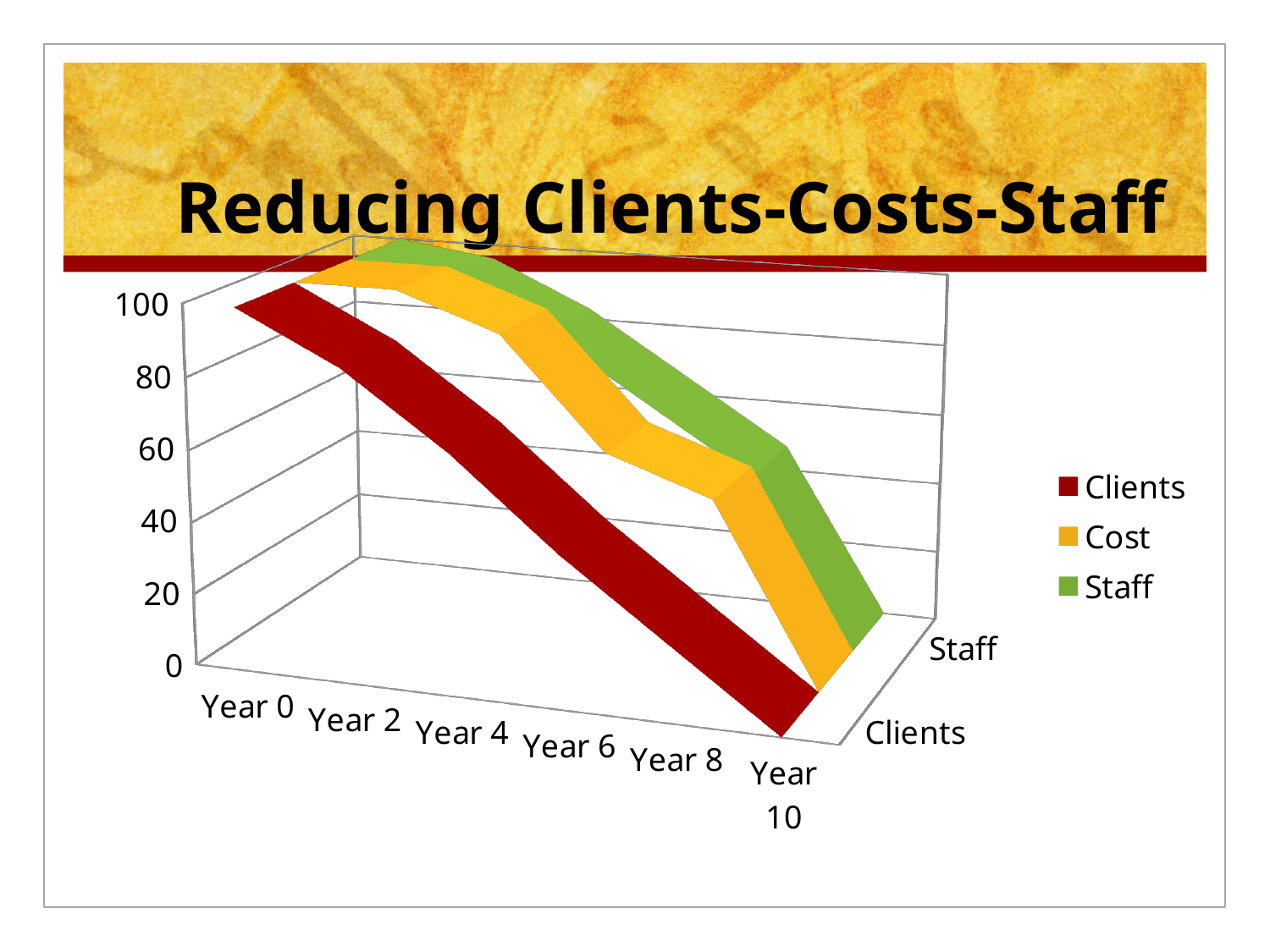
How many series does the legend list? 3 Do the values for the Clients series rise or fall from Year 0 to Year 10? fall What is the title of the chart? Reducing Clients-Costs-Staff What kind of chart is shown on the slide? 3D line chart Is the value for Clients at Year 10 greater or less than 40? less Do the values for the Staff series rise or fall from Year 0 to Year 10? fall Is the value for Clients at Year 0 greater or less than 60? greater How many year categories are shown along the x axis? 6 What is the last category label on the x axis? Year 10 What is the first category label on the x axis? Year 0 Which series is shown in dark red? Clients